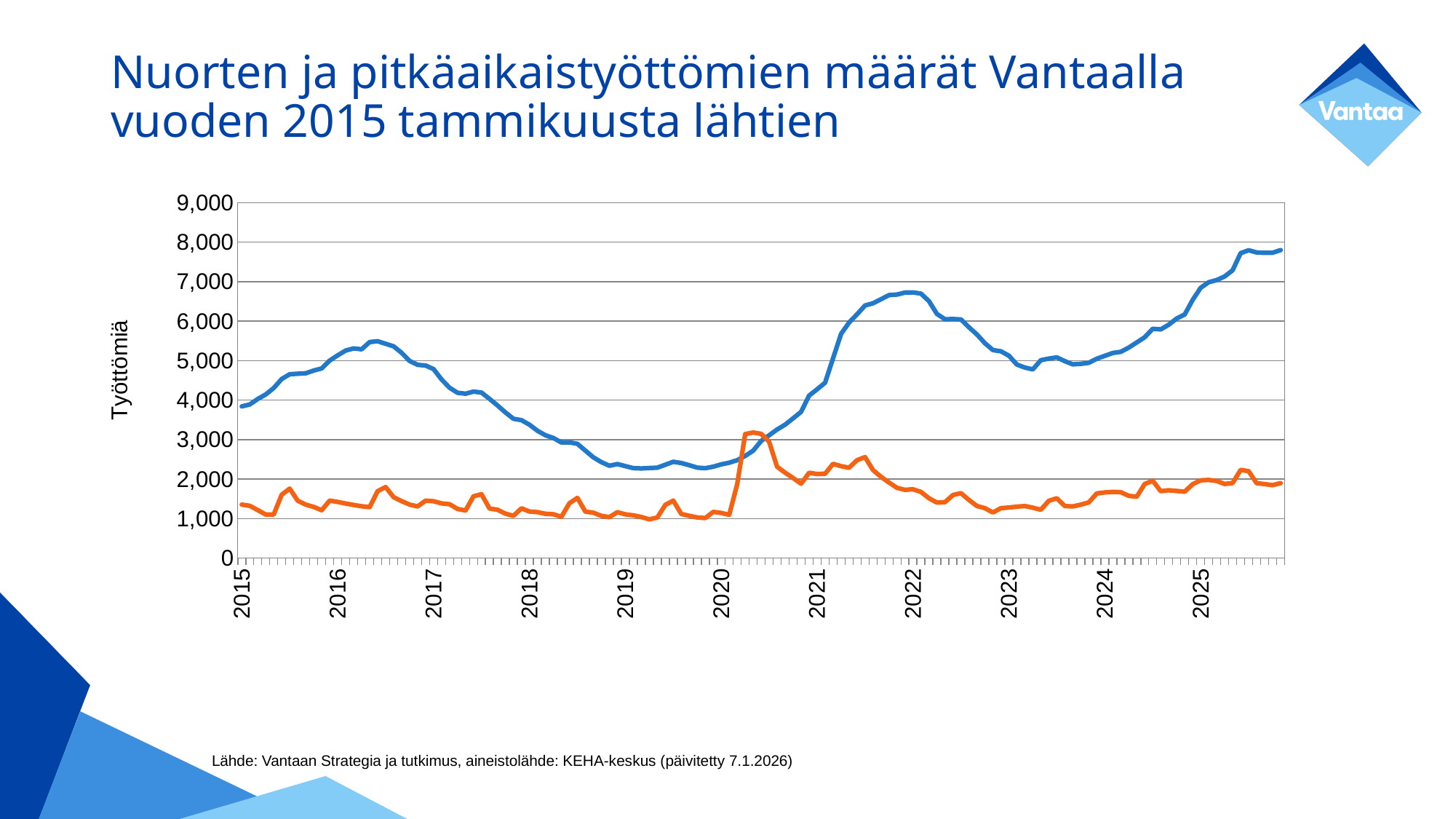
Is the peak of the orange line in 2020 greater or less than 2,500? greater How many lines are plotted on the chart? 2 What kind of chart is shown on the slide? line chart Does the blue line rise or fall between 2023 and 2025? rise What is the label on the vertical axis of the chart? Työttömiä Is the value of the orange line at the start of 2023 greater or less than 2,000? less At the start of 2025, which line has the higher value, the blue line or the orange line? the blue line What is the title of the chart on the slide? Nuorten ja pitkäaikaistyöttömien määrät Vantaalla vuoden 2015 tammikuusta lähtien Is the value of the blue line at the end of 2025 greater or less than 7,000? greater How many year labels are shown on the horizontal axis? 11 In which year does the blue line reach its highest value? 2025